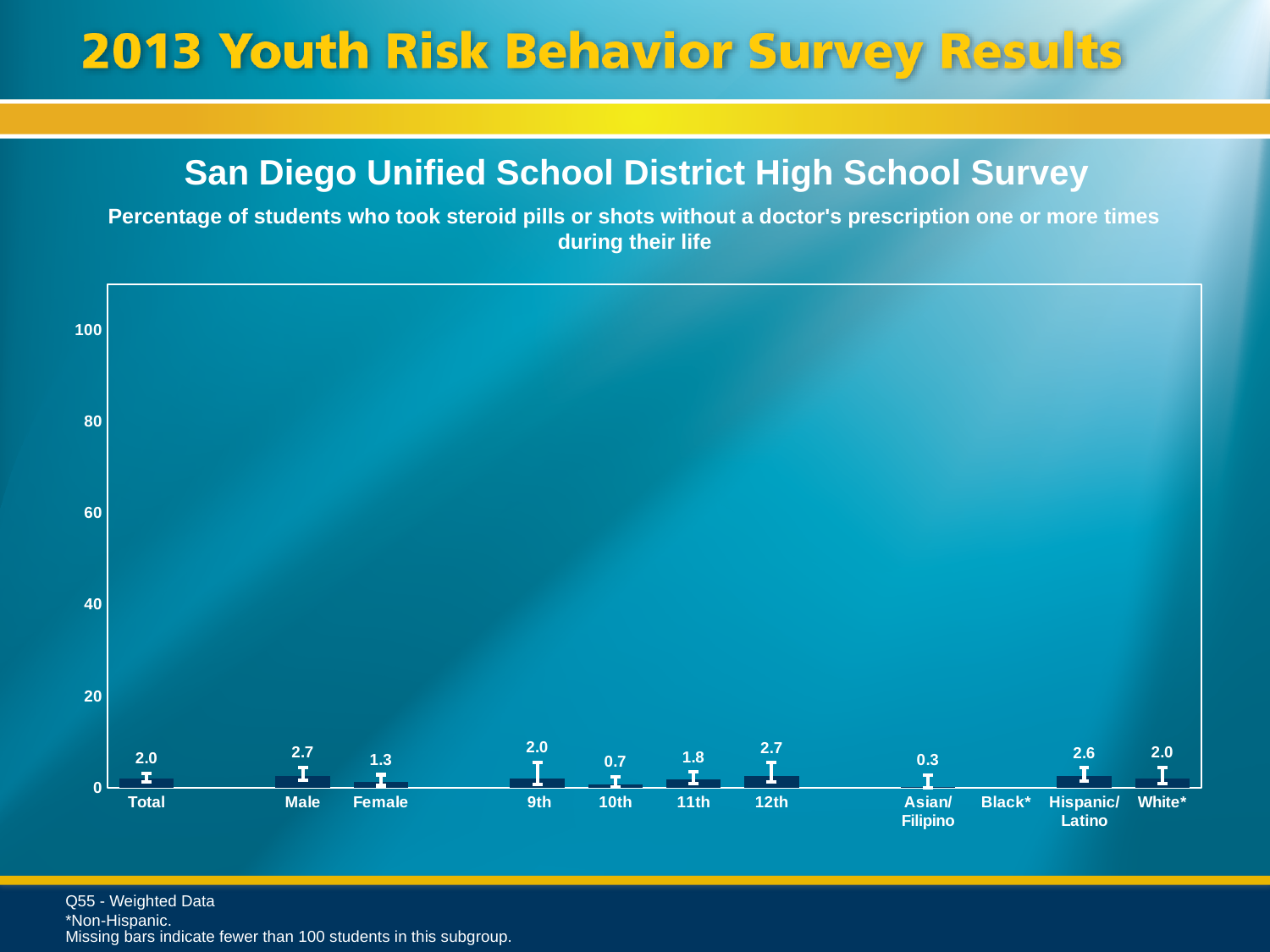
What percentage of Male students took steroid pills or shots without a doctor's prescription? 2.7 What is the difference between the values for Male and Female students? 1.4 Is the value for 12th grade greater or less than 20? less What is the value shown for 10th grade students? 0.7 How many category labels are shown along the x axis? 11 Which category has no bar displayed on the chart? Black* What is the value shown for Asian/Filipino students? 0.3 Which is larger, the value for Hispanic/Latino or the value for White*? Hispanic/Latino Which category has the lowest value on the chart? Asian/Filipino Among the grade levels (9th, 10th, 11th, 12th), which has the highest value? 12th What kind of chart is shown on the slide? bar chart What is the value shown for Female students? 1.3